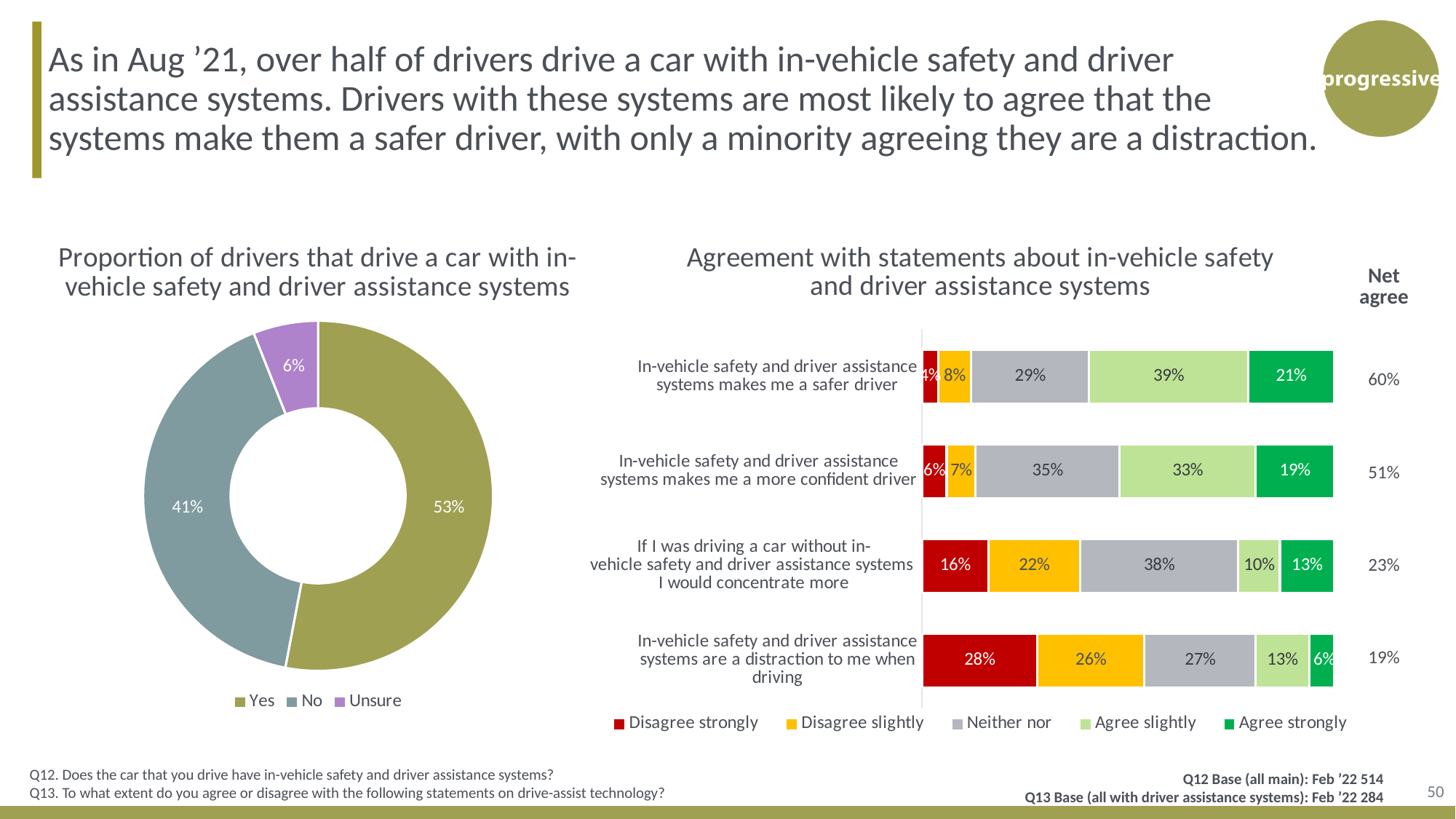
How many categories does the legend of the 'Proportion of drivers that drive a car with in-vehicle safety and driver assistance systems' chart list? 3 In the 'Agreement with statements about in-vehicle safety and driver assistance systems' chart, how many series does the legend list? 5 In the 'Proportion of drivers that drive a car with in-vehicle safety and driver assistance systems' chart, what percentage of drivers answered Yes? 53% In the 'Agreement with statements about in-vehicle safety and driver assistance systems' chart, which statement has the highest Net agree value? In-vehicle safety and driver assistance systems makes me a safer driver In the 'Agreement with statements about in-vehicle safety and driver assistance systems' chart, what percentage disagree strongly that the systems are a distraction to them when driving? 28% In the 'Proportion of drivers that drive a car with in-vehicle safety and driver assistance systems' chart, what is the difference between the Yes and No shares? 12% In the 'Agreement with statements about in-vehicle safety and driver assistance systems' chart, what is the difference between the Agree strongly shares for 'makes me a safer driver' and 'are a distraction to me when driving'? 15% What type of chart is the 'Proportion of drivers that drive a car with in-vehicle safety and driver assistance systems' chart? Pie (doughnut) chart In the 'Agreement with statements about in-vehicle safety and driver assistance systems' chart, what percentage agree slightly that the systems make them a safer driver? 39% In the 'Agreement with statements about in-vehicle safety and driver assistance systems' chart, what is the Net agree value for 'If I was driving a car without in-vehicle safety and driver assistance systems I would concentrate more'? 23% In the 'Agreement with statements about in-vehicle safety and driver assistance systems' chart, which is larger: the Neither nor share for 'makes me a more confident driver' or for 'makes me a safer driver'? Makes me a more confident driver (35%) In the 'Proportion of drivers that drive a car with in-vehicle safety and driver assistance systems' chart, which category has the smallest share? Unsure